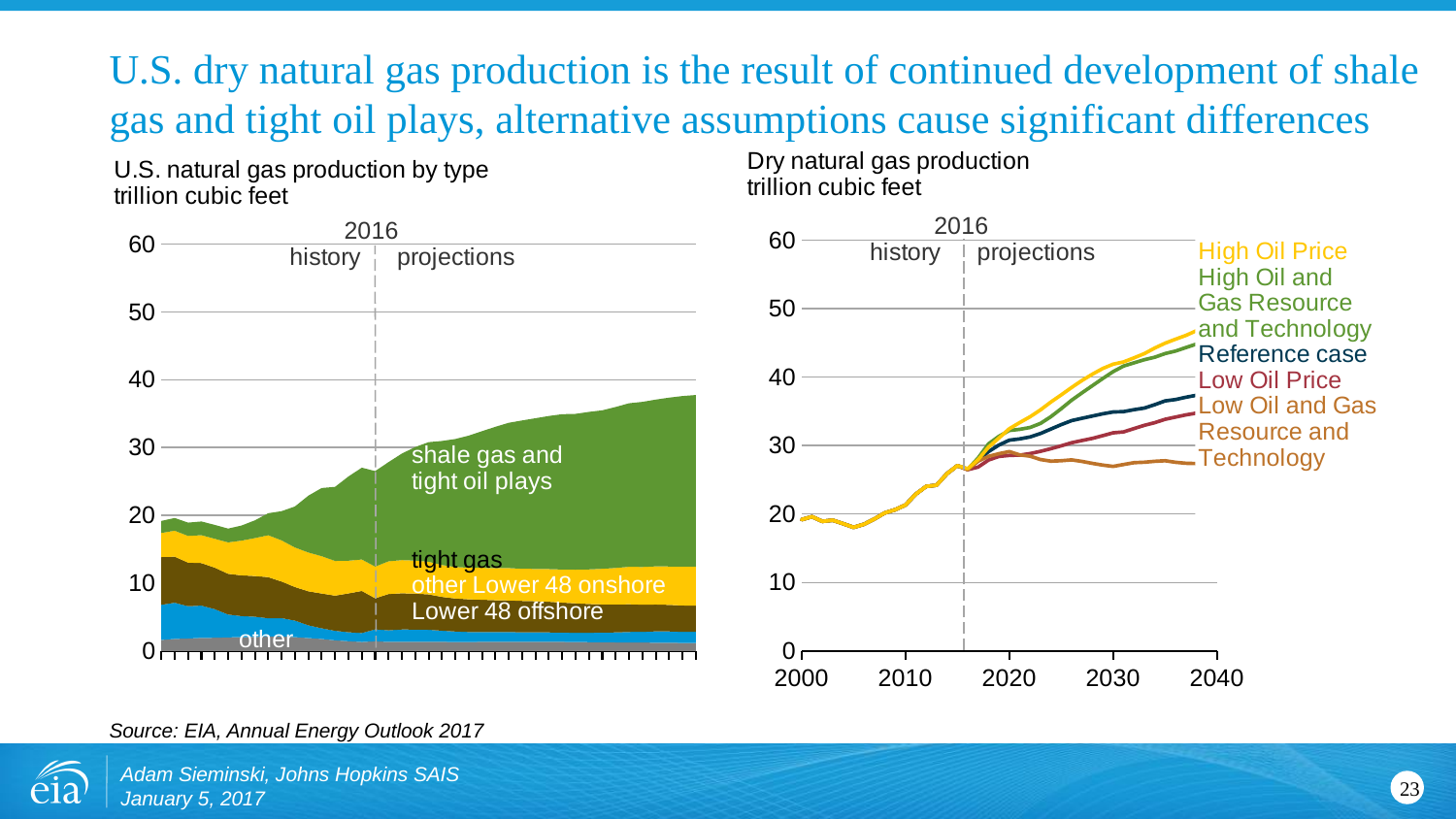
In the "Dry natural gas production" chart, which scenario has the lowest production in 2040? Low Oil and Gas Resource and Technology In the "Dry natural gas production" chart, how many scenario lines are labelled? 5 In the "Dry natural gas production" chart, which is higher in 2040, the Reference case or the Low Oil Price case? Reference case In the "Dry natural gas production" chart, is the Low Oil and Gas Resource and Technology value in 2040 greater or less than 30? less In the "U.S. natural gas production by type" chart, how many production types are labelled? 5 In the "Dry natural gas production" chart, does the Reference case rise or fall over the projection period after 2016? rise What year does the dashed vertical line separating history from projections mark on both charts? 2016 What kind of chart is the left-hand chart titled "U.S. natural gas production by type"? stacked area chart In the "Dry natural gas production" chart, which scenario has the highest production in 2040? High Oil Price In the "Dry natural gas production" chart, is the High Oil Price value in 2040 greater or less than 40? greater What kind of chart is the right-hand chart titled "Dry natural gas production"? line chart In the "U.S. natural gas production by type" chart, which production type is the largest component at the end of the projection period? shale gas and tight oil plays